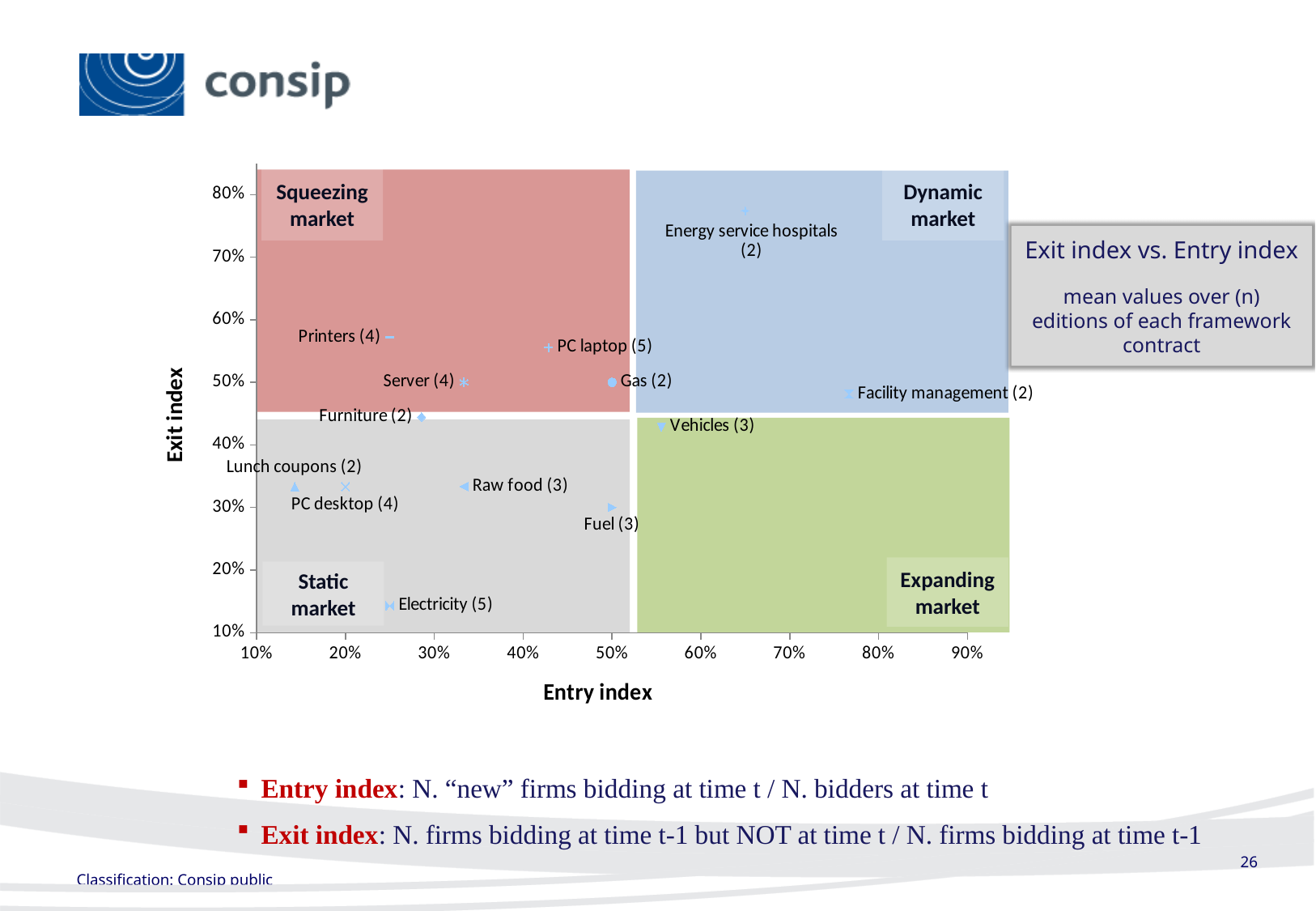
Is the exit index for Electricity (5) greater or less than 20%? less Is the entry index for Facility management (2) greater or less than 70%? greater How many framework contracts (data points) are plotted on the chart? 13 Which framework contract has the highest exit index? Energy service hospitals (2) Which framework contract has the lowest exit index? Electricity (5) What is the name of the quadrant shaded green in the lower right of the chart? Expanding market Which framework contract has the highest entry index? Facility management (2) What kind of chart is shown on the slide? Scatter chart What is the label of the horizontal axis of the chart? Entry index Is the exit index for Energy service hospitals (2) greater or less than 70%? greater Which has a higher exit index, Energy service hospitals (2) or Fuel (3)? Energy service hospitals (2)